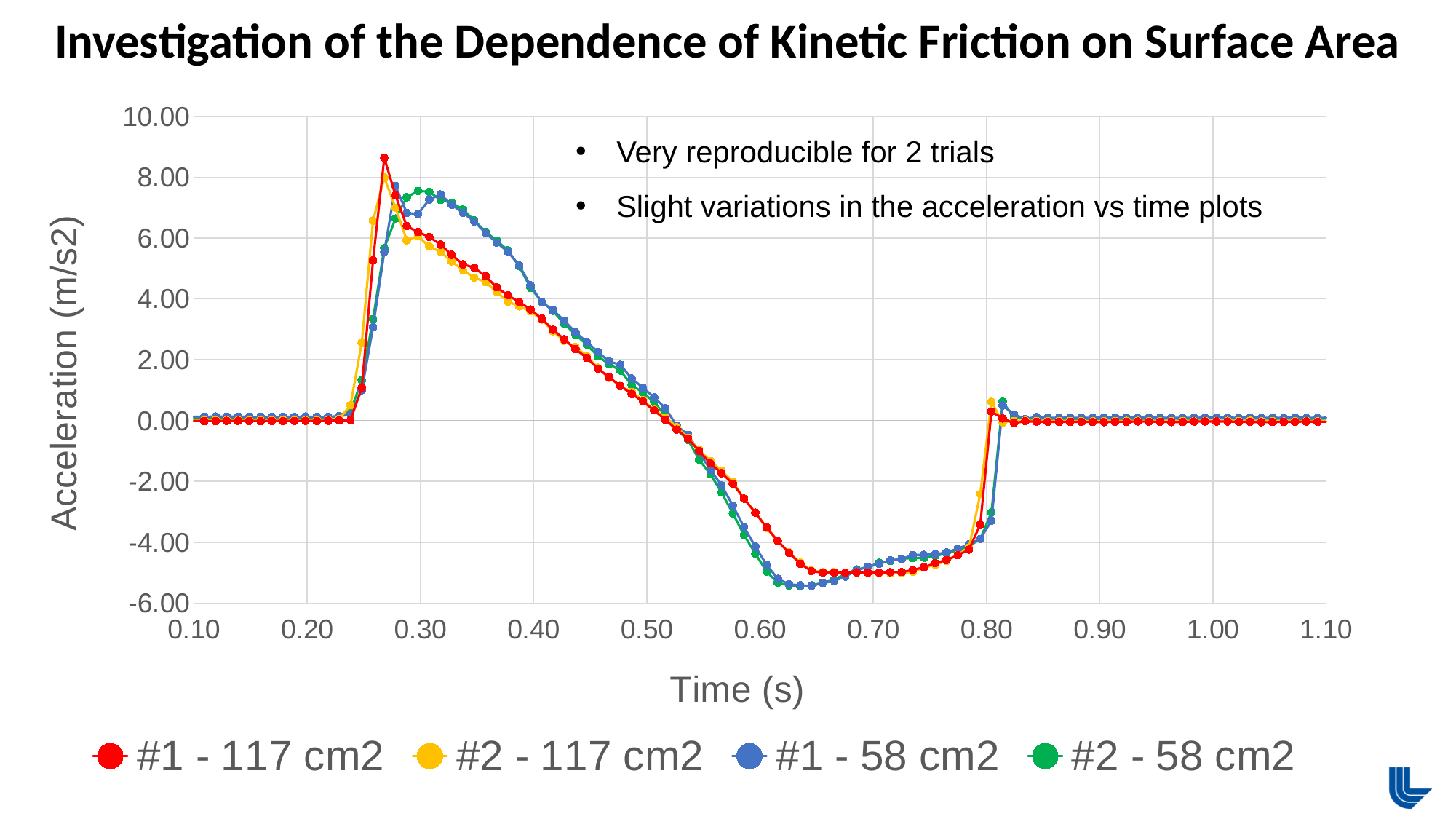
What is the title of the vertical axis? Acceleration (m/s2) Is the peak value of the #2 - 58 cm2 series near 0.30 s greater or less than 8.00? less Which series is plotted in green? #2 - 58 cm2 Is the lowest value of the #1 - 58 cm2 series near 0.63 s greater or less than -4.00? less Is the peak value of the #1 - 117 cm2 series near 0.27 s greater or less than 8.00? greater Between 0.20 s and 0.27 s, does the #1 - 117 cm2 series rise or fall? rise How many series does the legend list? 4 Between 0.30 s and 0.60 s, do the acceleration values rise or fall as time increases? fall Which series reaches the highest acceleration on the chart? #1 - 117 cm2 What kind of chart is shown on the slide? line chart